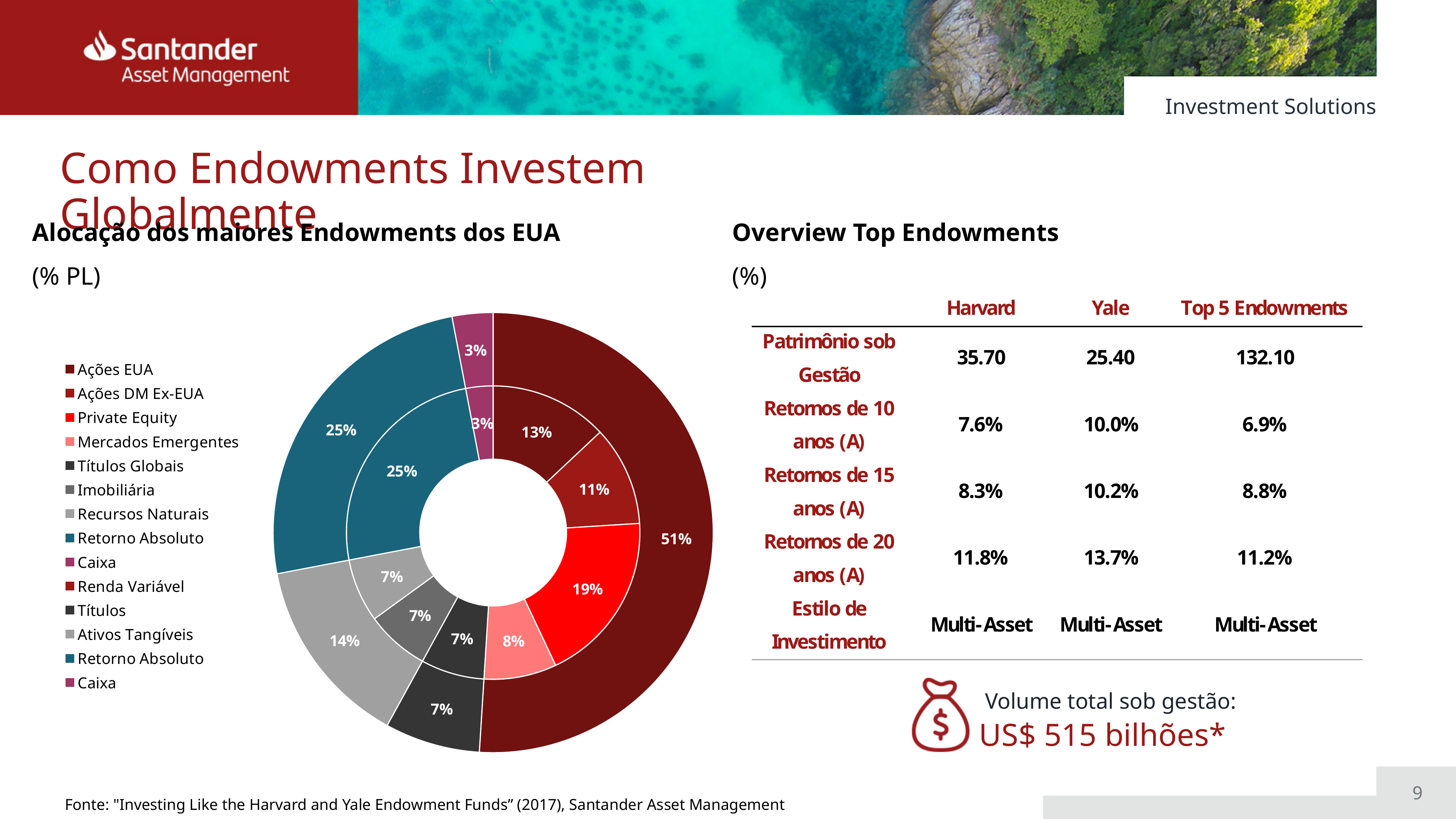
In the allocation doughnut chart, which is larger: Ações EUA or Ações DM Ex-EUA? Ações EUA In the allocation doughnut chart, what is the difference in percentage points between Private Equity and Mercados Emergentes? 11 percentage points In the allocation doughnut chart, what is the difference in percentage points between Renda Variável and Retorno Absoluto in the outer ring? 26 percentage points In the allocation doughnut chart, what percentage is shown for Renda Variável in the outer ring? 51% In the allocation doughnut chart, which category has the smallest share? Caixa In the allocation doughnut chart, what percentage is shown for Ativos Tangíveis? 14% In the allocation doughnut chart, what percentage is shown for Private Equity? 19% In the allocation doughnut chart, what percentage is shown for Mercados Emergentes? 8% What unit is indicated in the subtitle of the allocation doughnut chart? % PL In the allocation doughnut chart, which category in the outer ring has the largest share? Renda Variável How many entries does the legend of the allocation doughnut chart list? 14 What kind of chart is used to show the allocation of the largest US endowments (Alocação dos maiores Endowments dos EUA)? doughnut chart